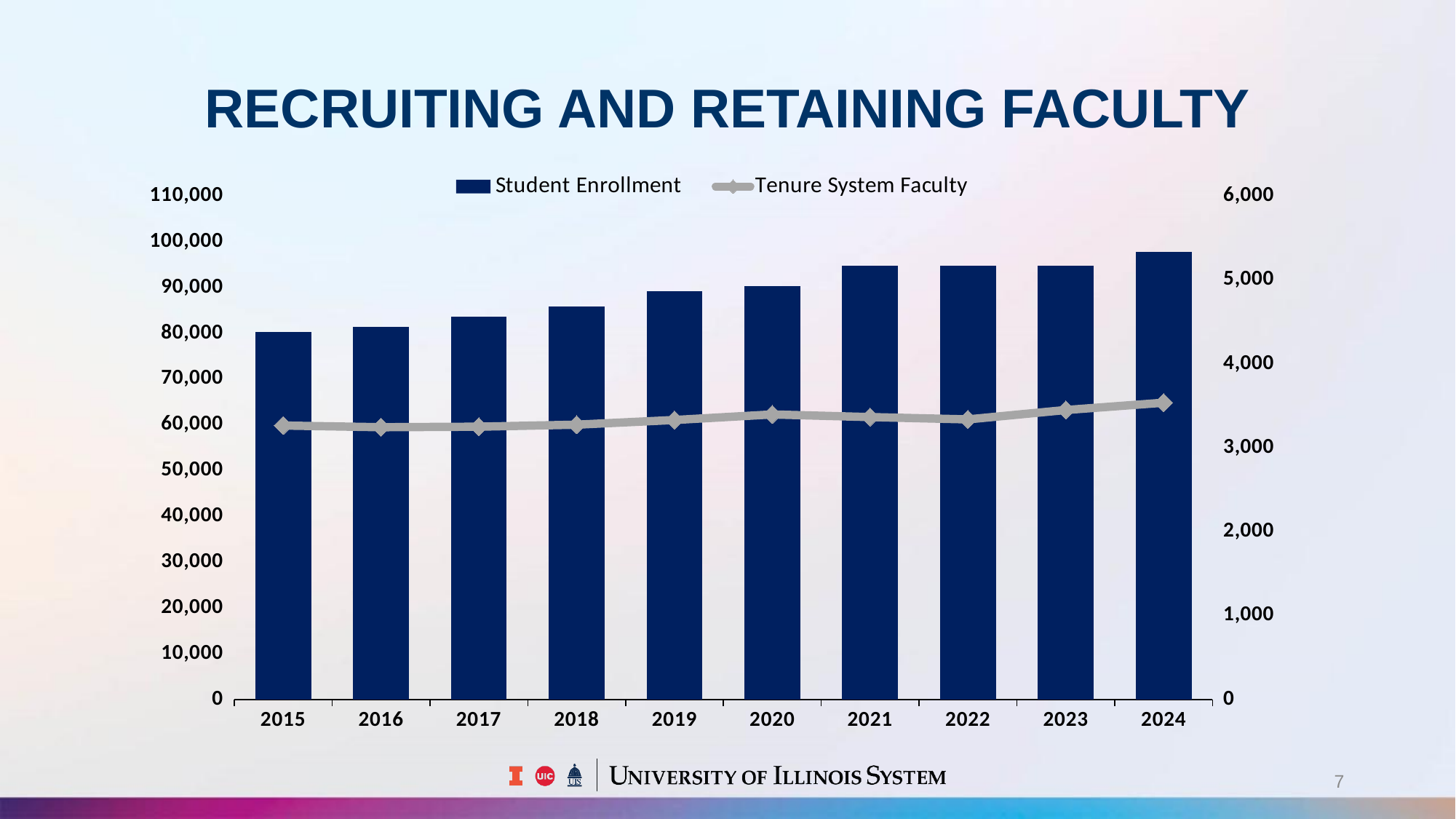
Is the Student Enrollment value for 2024 greater or less than 90,000? greater Which year has the larger Student Enrollment, 2018 or 2021? 2021 Which year has the highest Student Enrollment? 2024 How many series does the legend list? 2 Which series is plotted as a line with markers? Tenure System Faculty Does Student Enrollment generally rise or fall from 2015 to 2024? rise Which year has the highest Tenure System Faculty value? 2024 How many years are shown on the x axis? 10 Is the Student Enrollment value for 2015 greater or less than 90,000? less What type of chart is shown on the slide? Combined bar and line chart Is the Tenure System Faculty value for 2020 greater or less than 3,000? greater